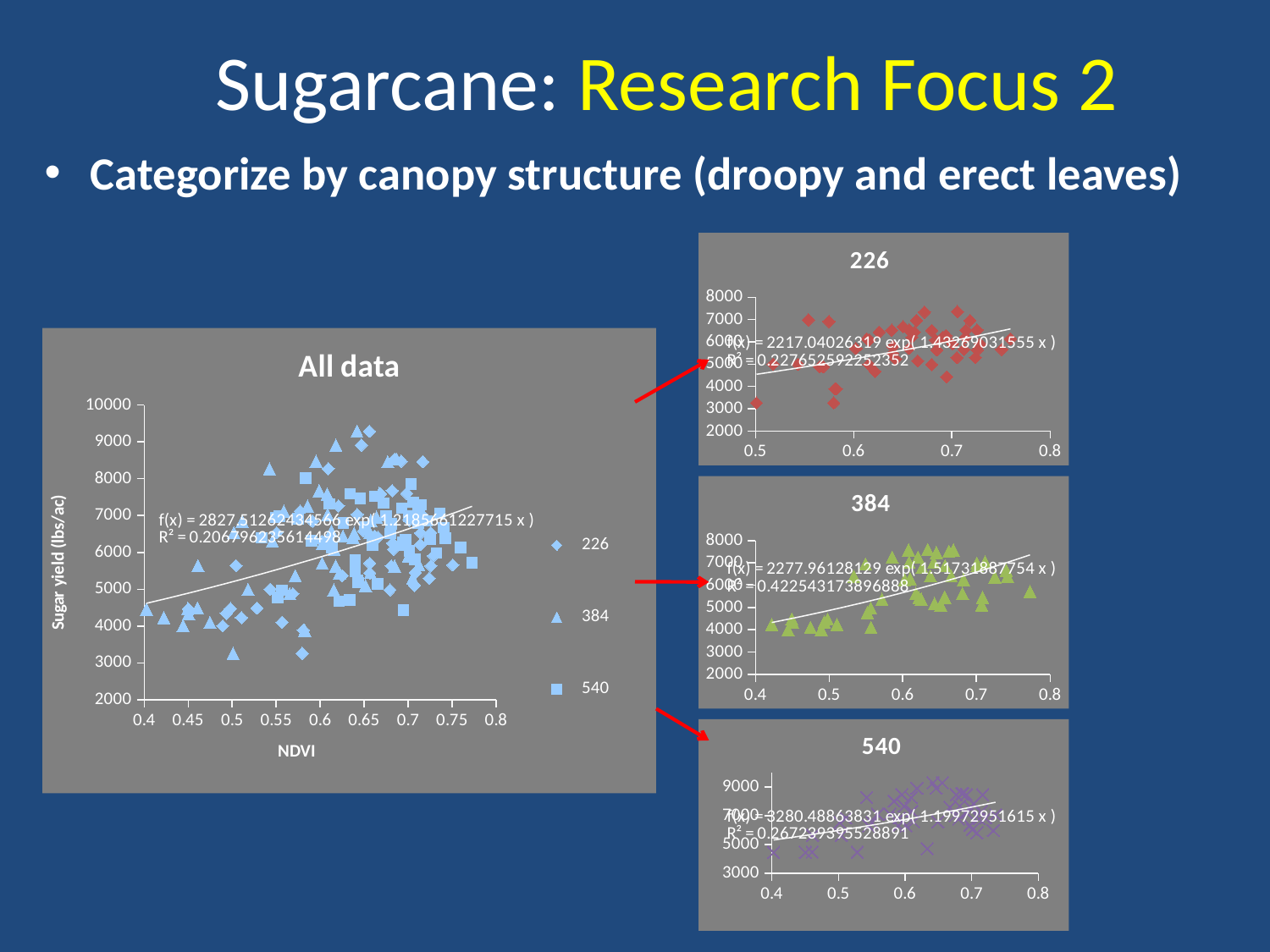
What is the R² value printed on the "540" chart? 0.267239395528891 What is the R² value printed on the "226" chart? 0.227652592252352 Which of the three category charts (226, 384, 540) has the highest R² value? 384 What is the y-axis title of the "All data" chart? Sugar yield (lbs/ac) What kind of chart is the "All data" chart? scatter chart In the "All data" chart, does the fitted trendline rise or fall as NDVI increases? rise What are the legend entries in the "All data" chart? 226, 384, 540 Is the R² value on the "226" chart larger or smaller than the R² value on the "540" chart? smaller What is the R² value printed on the "384" chart? 0.422543173896888 What is the R² value printed on the "All data" chart? 0.206796235614498 How many charts are shown on the slide? 4 How many series does the legend of the "All data" chart list? 3